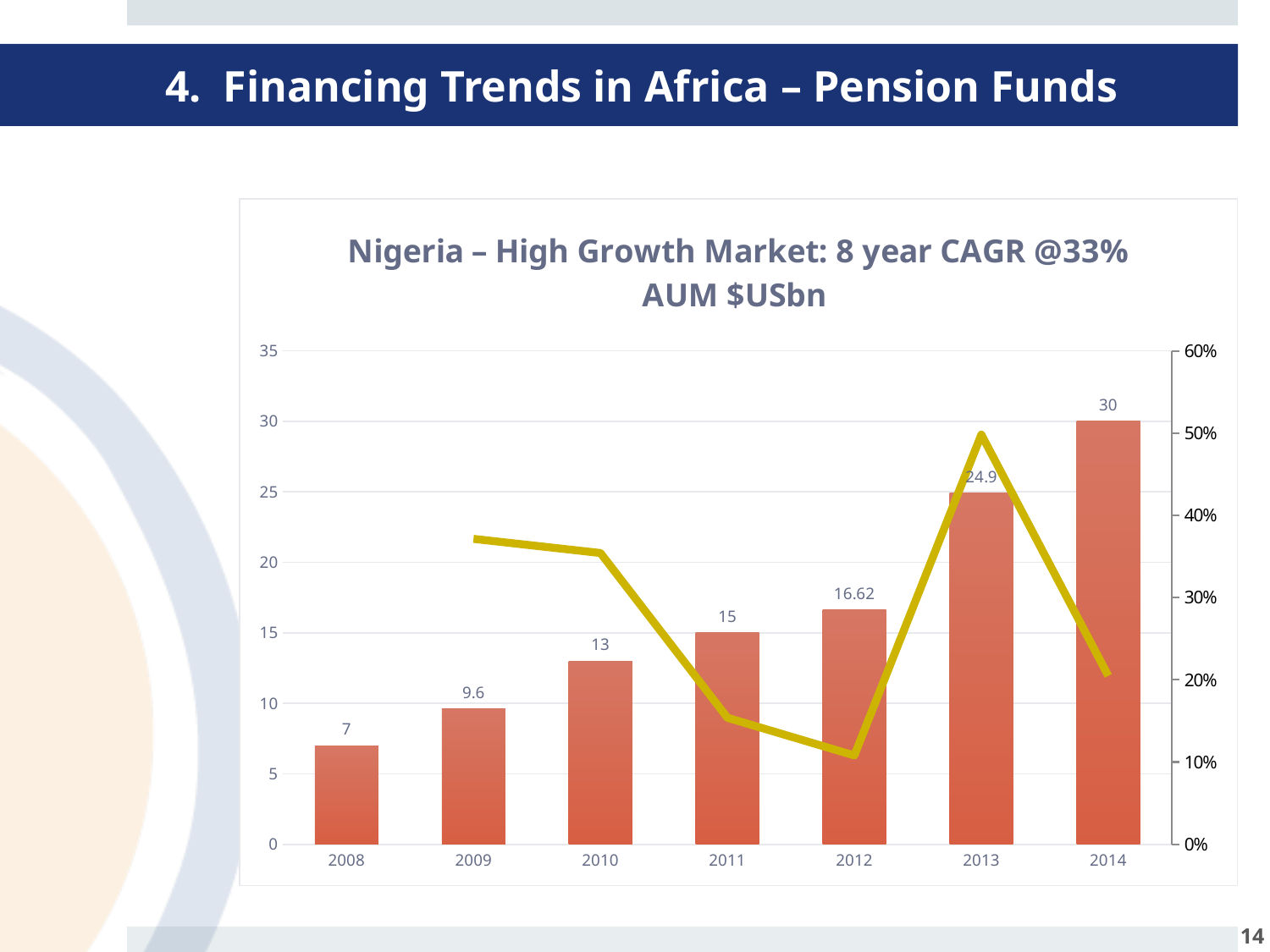
What is the difference between the AUM values for 2011 and 2010? 2 Is the value of the yellow line for 2013 on the right-hand axis greater or less than 40%? greater How many years are shown on the x axis? 7 What is the AUM value for 2009? 9.6 Which year has the lowest AUM bar? 2008 What is the AUM value for 2012? 16.62 Which year has the highest AUM bar? 2014 Do the AUM bars rise or fall from 2008 to 2014? rise What is the AUM value for 2013? 24.9 Is the value of the yellow line for 2012 on the right-hand axis greater or less than 20%? less Which year has a larger AUM bar, 2010 or 2012? 2012 What is the difference between the AUM values for 2014 and 2013? 5.1